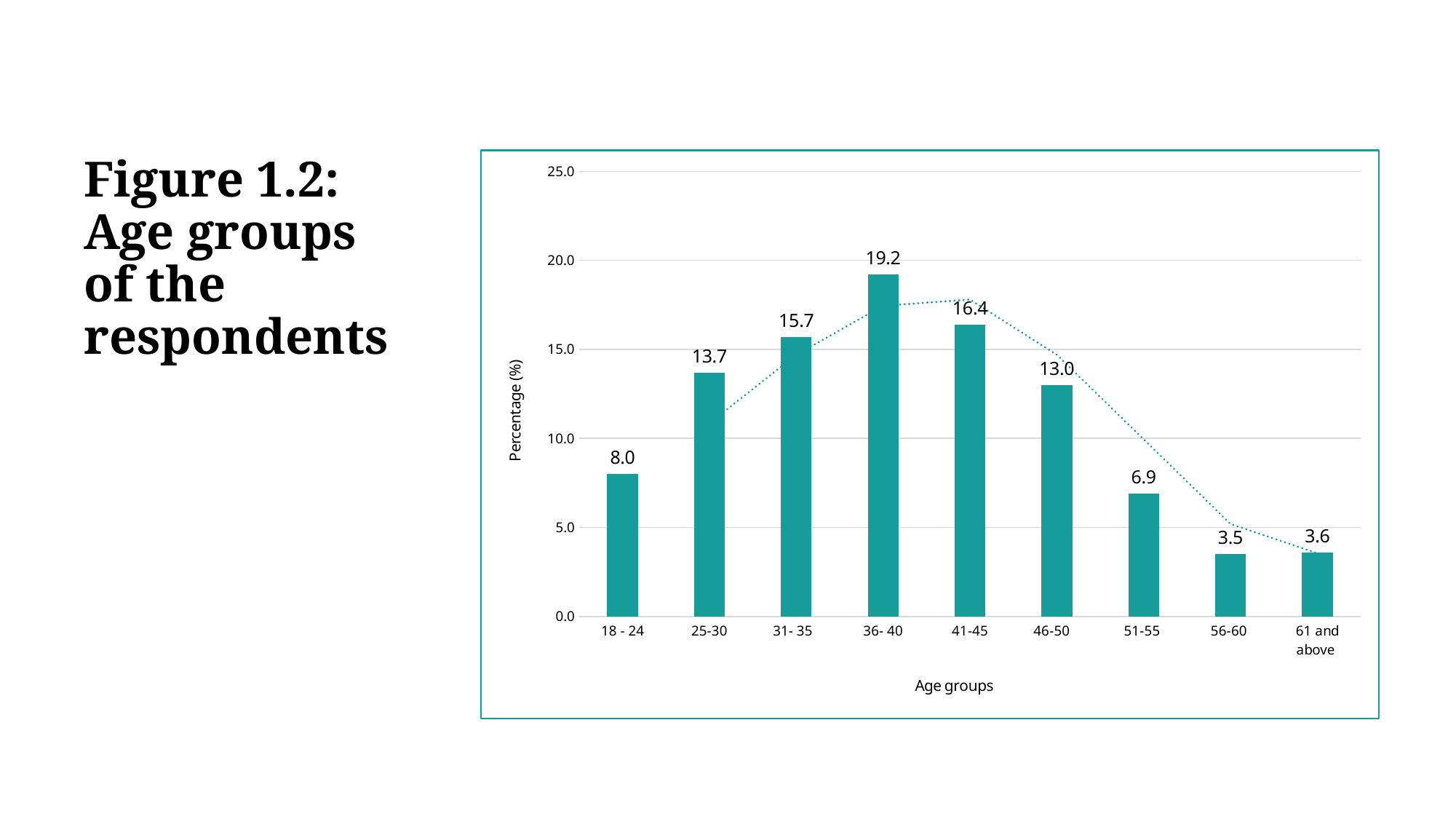
Which age group has a larger percentage, 31- 35 or 46-50? 31- 35 What is the difference between the percentages for the 36- 40 and 41-45 age groups? 2.8 What is the label of the vertical axis? Percentage (%) What is the percentage for the 51-55 age group? 6.9 Which age group has the highest percentage? 36- 40 What is the percentage for the 18 - 24 age group? 8.0 What is the difference between the percentages for the 25-30 and 46-50 age groups? 0.7 Which age group has the lowest percentage? 56-60 Is the value for the 25-30 age group greater or less than 15.0? less What is the percentage for the 36- 40 age group? 19.2 What kind of chart is shown on the slide? bar chart How many age groups are shown on the chart? 9